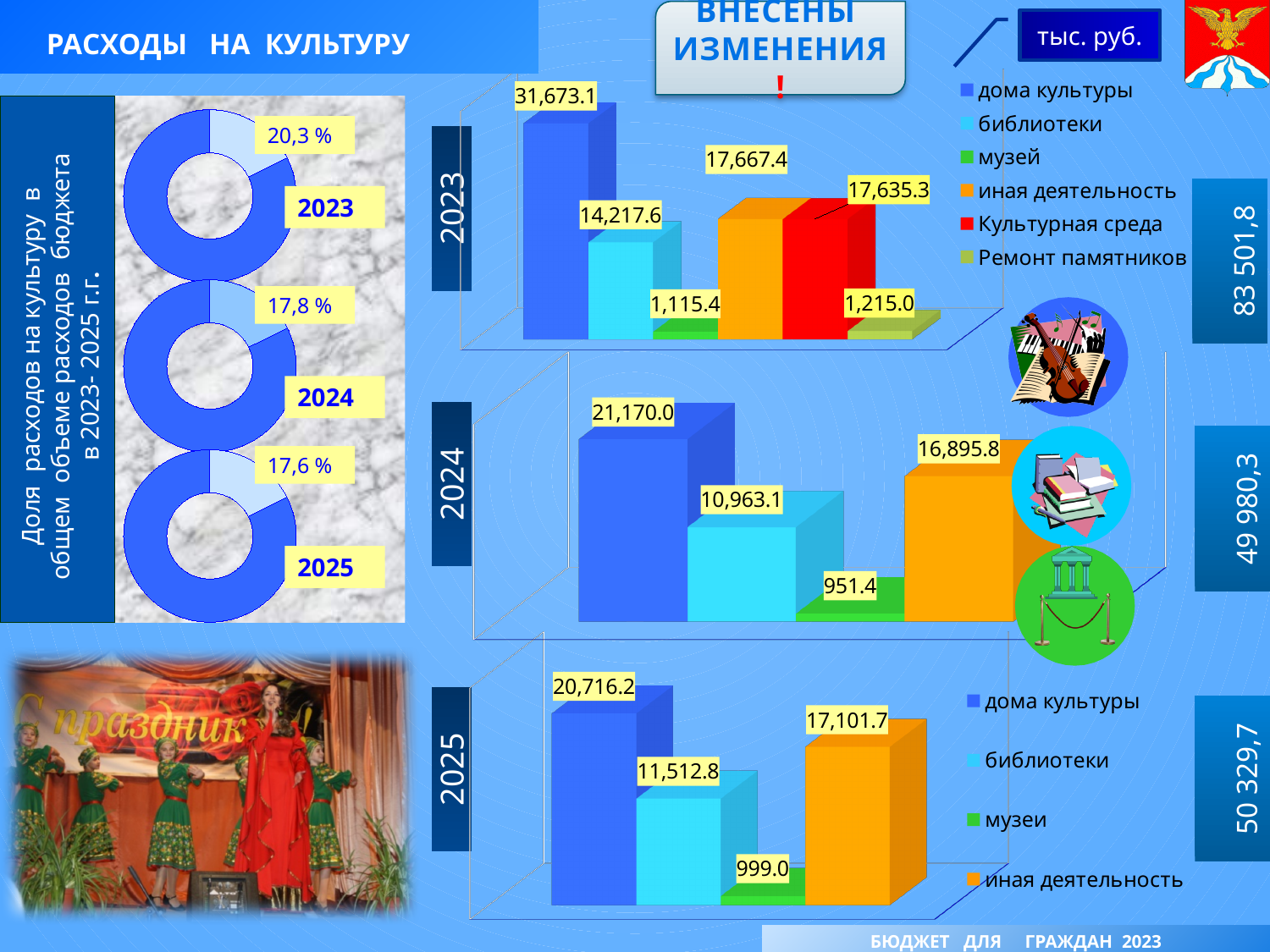
In the 2023 bar chart, what is the value for Культурная среда? 17,635.3 In the 2023 bar chart, which category has the lowest value? музей In the 2024 bar chart, what is the value for библиотеки? 10,963.1 In the 2025 bar chart, what is the value for музеи? 999.0 In the 2025 bar chart, which is larger: библиотеки or иная деятельность? иная деятельность What kind of chart is used to show the 2025 expenditure breakdown? bar chart In the donut chart for 2024, what share of total budget expenditure goes to culture? 17,8 % In the 2024 bar chart, which category has the highest value? дома культуры In the 2023 bar chart, what is the value for дома культуры? 31,673.1 How many categories are shown in the 2025 bar chart? 4 In the 2024 bar chart, what is the difference between дома культуры and иная деятельность? 4,274.2 How many series does the legend of the 2023 bar chart list? 6